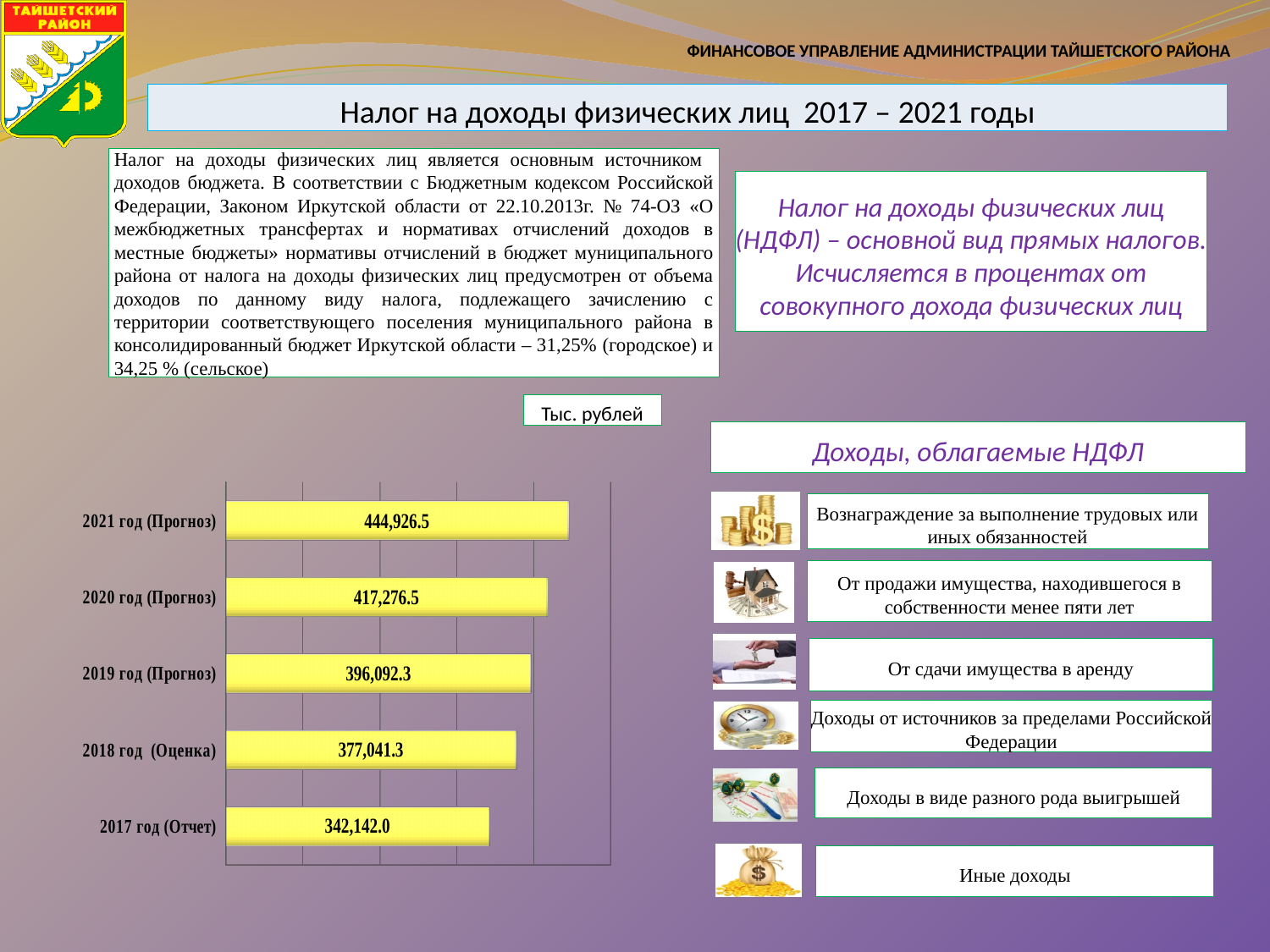
What is the value for 2017 год (Отчет) in the bar chart? 342,142.0 How many categories are shown in the bar chart? 5 What is the difference between the values for 2021 год (Прогноз) and 2017 год (Отчет)? 102,784.5 Which category has the highest value in the bar chart? 2021 год (Прогноз) What type of chart is shown on the slide? bar chart Which is larger, the value for 2018 год (Оценка) or the value for 2019 год (Прогноз)? 2019 год (Прогноз) What is the difference between the values for 2020 год (Прогноз) and 2019 год (Прогноз)? 21,184.2 What is the value for 2019 год (Прогноз) in the bar chart? 396,092.3 What is the value for 2021 год (Прогноз) in the bar chart? 444,926.5 What is the value for 2018 год (Оценка) in the bar chart? 377,041.3 Which category has the lowest value in the bar chart? 2017 год (Отчет) What is the value for 2020 год (Прогноз) in the bar chart? 417,276.5